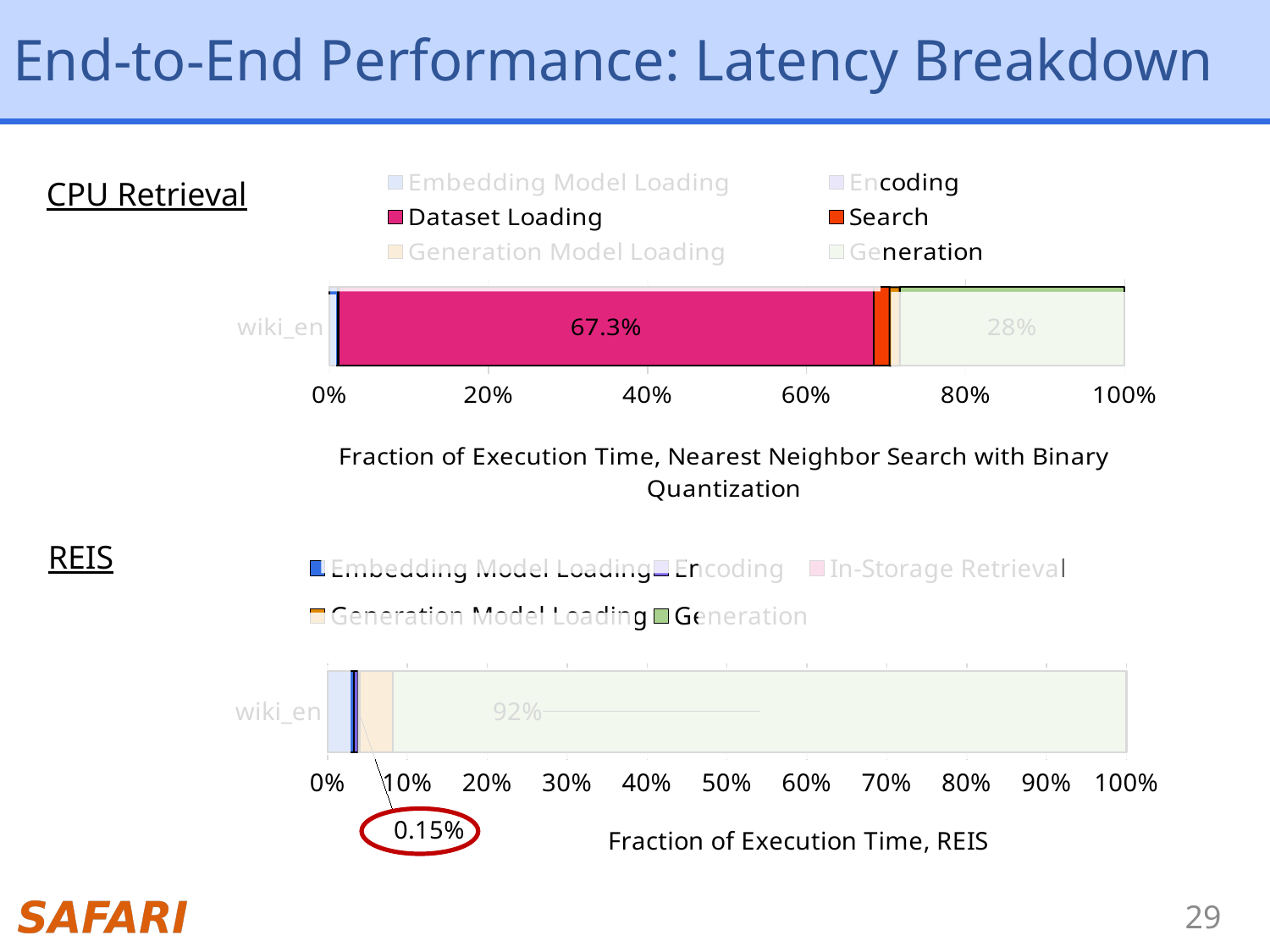
How many series does the legend of the REIS chart list? 5 In the REIS chart, is the value for Generation Model Loading greater or less than 10%? less In the REIS chart, which series takes the largest share of execution time for wiki_en? Generation In the CPU Retrieval chart, which is larger for wiki_en: Dataset Loading or Generation? Dataset Loading In the CPU Retrieval chart, what fraction of execution time does Generation take for wiki_en? 28% In the CPU Retrieval chart, what is the difference between the Dataset Loading and Generation fractions for wiki_en? 39.3 percentage points In the CPU Retrieval chart, what fraction of execution time does Dataset Loading take for wiki_en? 67.3% In the REIS chart, what fraction of execution time does Generation take for wiki_en? 92% How many categories are shown on the y axis of the REIS chart? 1 In the REIS chart, what value is highlighted in the circled callout for In-Storage Retrieval? 0.15% What kind of chart is the CPU Retrieval chart? Stacked bar chart How many series does the legend of the CPU Retrieval chart list? 6